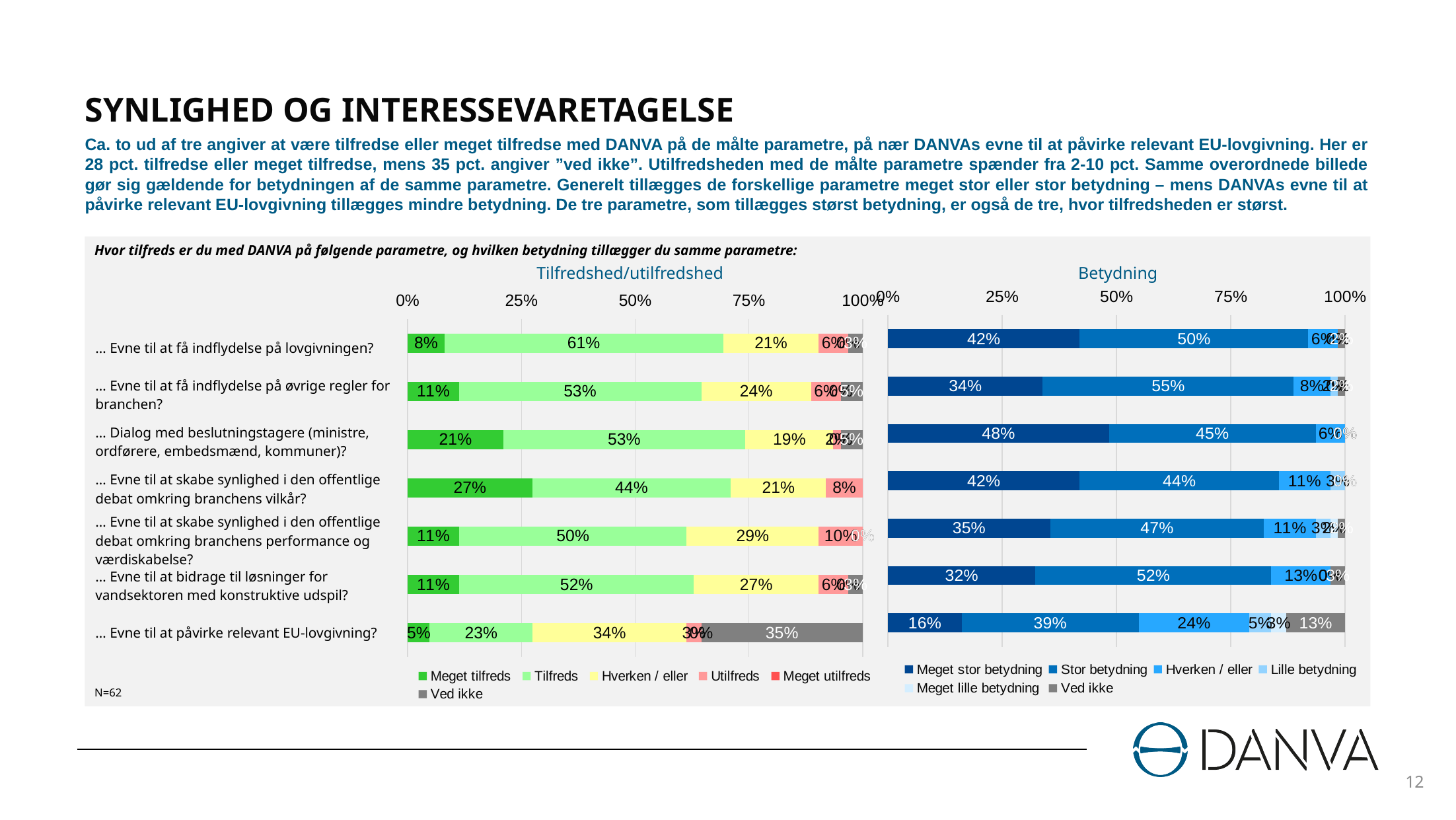
In the Betydning chart, what is the Meget stor betydning value for "Evne til at påvirke relevant EU-lovgivning?"? 16% In the Tilfredshed/utilfredshed chart, what is the difference between the Hverken / eller values for "Evne til at skabe synlighed i den offentlige debat omkring branchens performance og værdiskabelse?" and "Dialog med beslutningstagere (ministre, ordførere, embedsmænd, kommuner)?"? 10% In the Tilfredshed/utilfredshed chart, what is the Ved ikke value for "Evne til at påvirke relevant EU-lovgivning?"? 35% In the Betydning chart, what is the Stor betydning value for "Evne til at få indflydelse på øvrige regler for branchen?"? 55% In the Tilfredshed/utilfredshed chart, what is the Meget tilfreds value for "Evne til at skabe synlighed i den offentlige debat omkring branchens vilkår?"? 27% In the Tilfredshed/utilfredshed chart, which category has the lowest Meget tilfreds value? Evne til at påvirke relevant EU-lovgivning? What kind of chart is the Tilfredshed/utilfredshed chart? Stacked bar chart In the Tilfredshed/utilfredshed chart, what is the Tilfreds value for "Evne til at få indflydelse på lovgivningen?"? 61% How many series does the legend of the Betydning chart list? 6 In the Betydning chart, which is larger for "Evne til at bidrage til løsninger for vandsektoren med konstruktive udspil?": Meget stor betydning or Stor betydning? Stor betydning In the Betydning chart, which category has the highest Meget stor betydning value? Dialog med beslutningstagere (ministre, ordførere, embedsmænd, kommuner)? How many categories are shown in the Tilfredshed/utilfredshed chart? 7